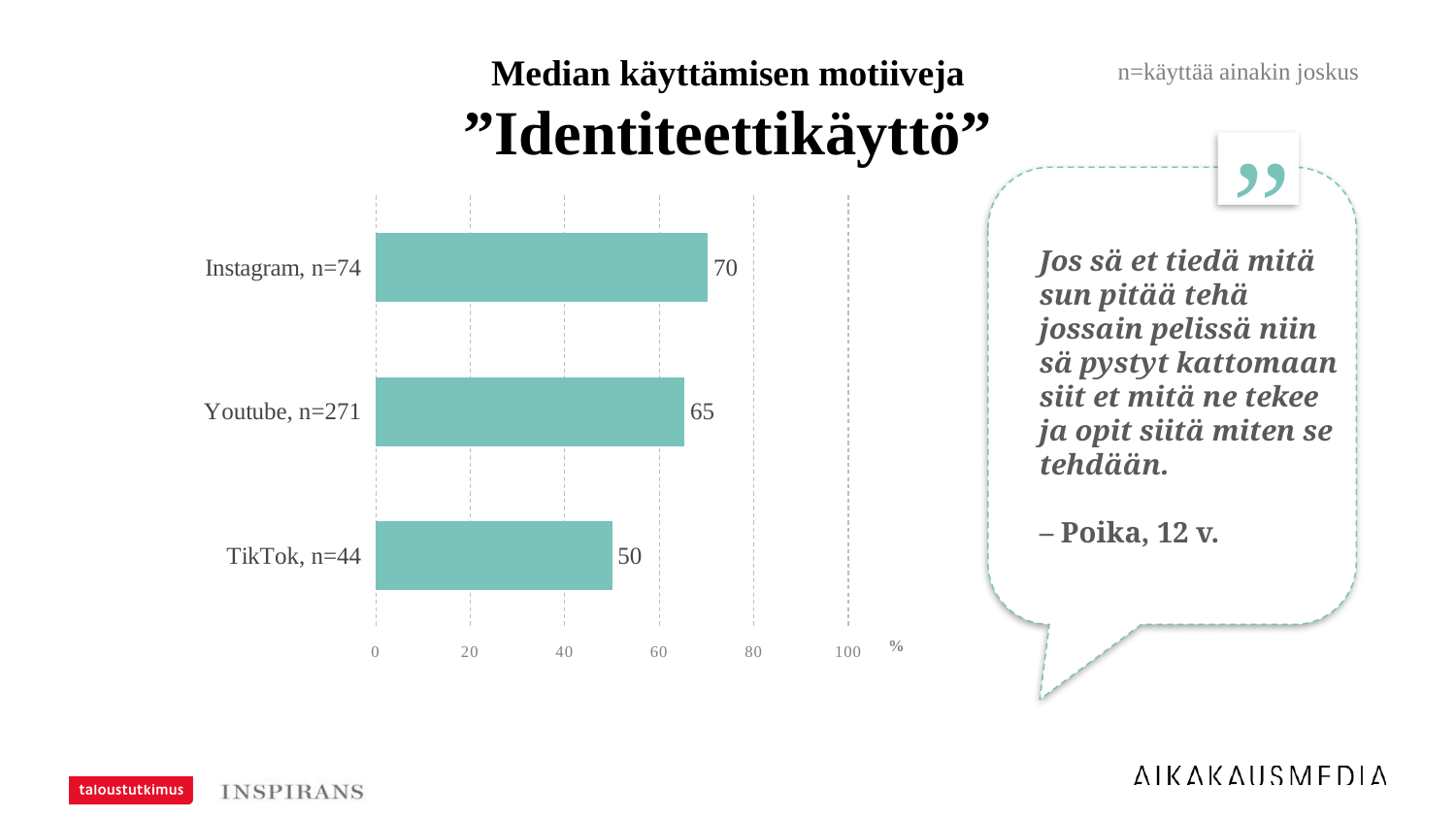
What kind of chart is shown on the slide? bar chart What is the difference between the values for Instagram, n=74 and Youtube, n=271? 5 Which is larger, the value for Youtube, n=271 or the value for TikTok, n=44? Youtube, n=271 What is the value for TikTok, n=44? 50 What is the value for Instagram, n=74? 70 How many categories are shown in the chart? 3 What is the title of the chart? Median käyttämisen motiiveja "Identiteettikäyttö" Which category has the highest value? Instagram, n=74 Is the value for Youtube, n=271 greater or less than 60? greater Which category has the lowest value? TikTok, n=44 What is the difference between the values for Instagram, n=74 and TikTok, n=44? 20 What is the value for Youtube, n=271? 65